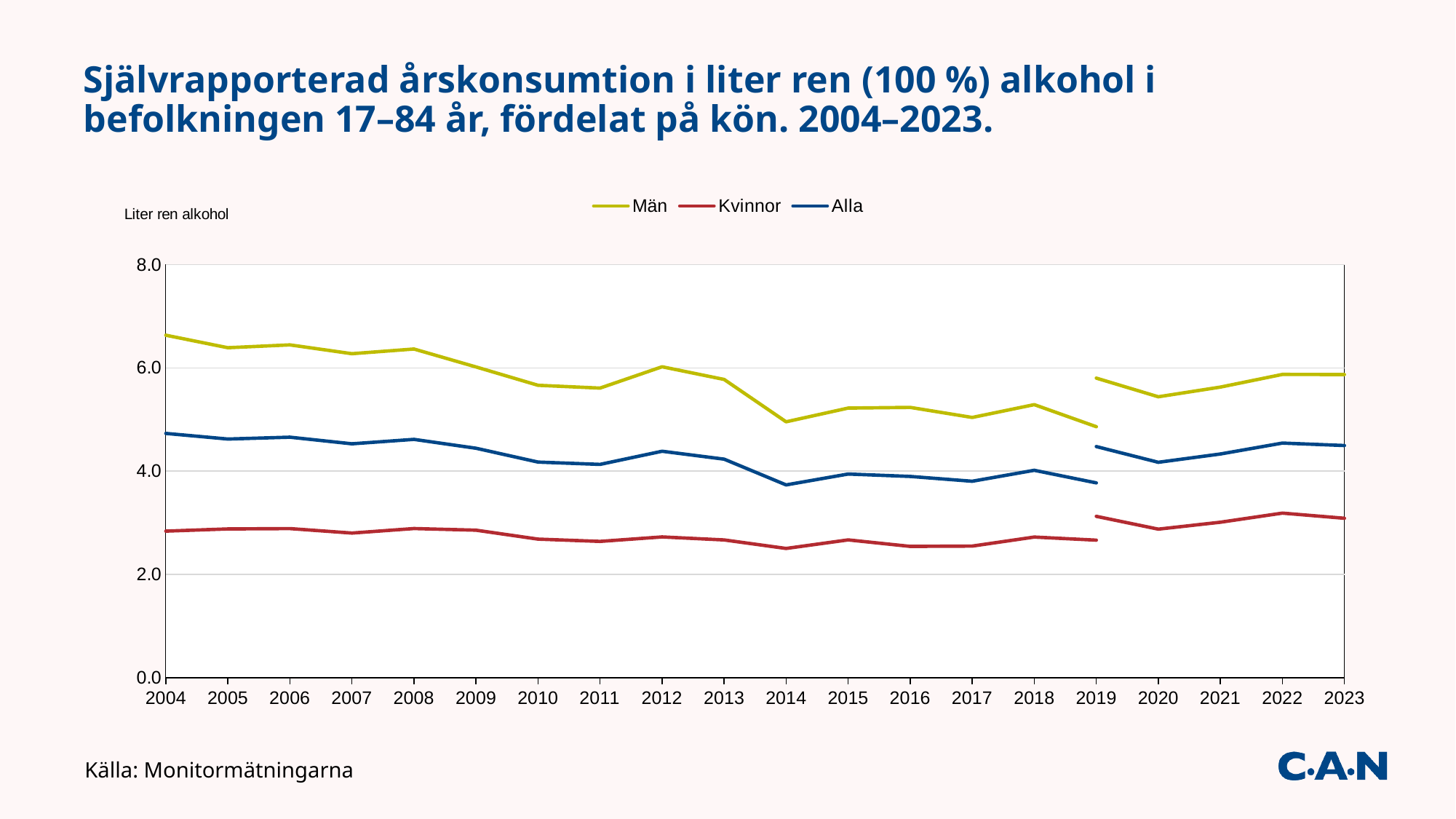
Is the value for Alla in 2014 greater or less than 4.0? less In which year is the value for Män highest? 2004 Is the value for Kvinnor in 2022 greater or less than 4.0? less Do the values for Män rise or fall from 2004 to 2014? fall Is the value for Män in 2004 greater or less than 6.0? greater What kind of chart is shown on the slide? line chart How many years are shown on the x axis? 20 What is the label on the y axis of the chart? Liter ren alkohol Which series has the higher value in 2012, Män or Kvinnor? Män Which series has the lower value in 2023, Alla or Kvinnor? Kvinnor How many series does the legend list? 3